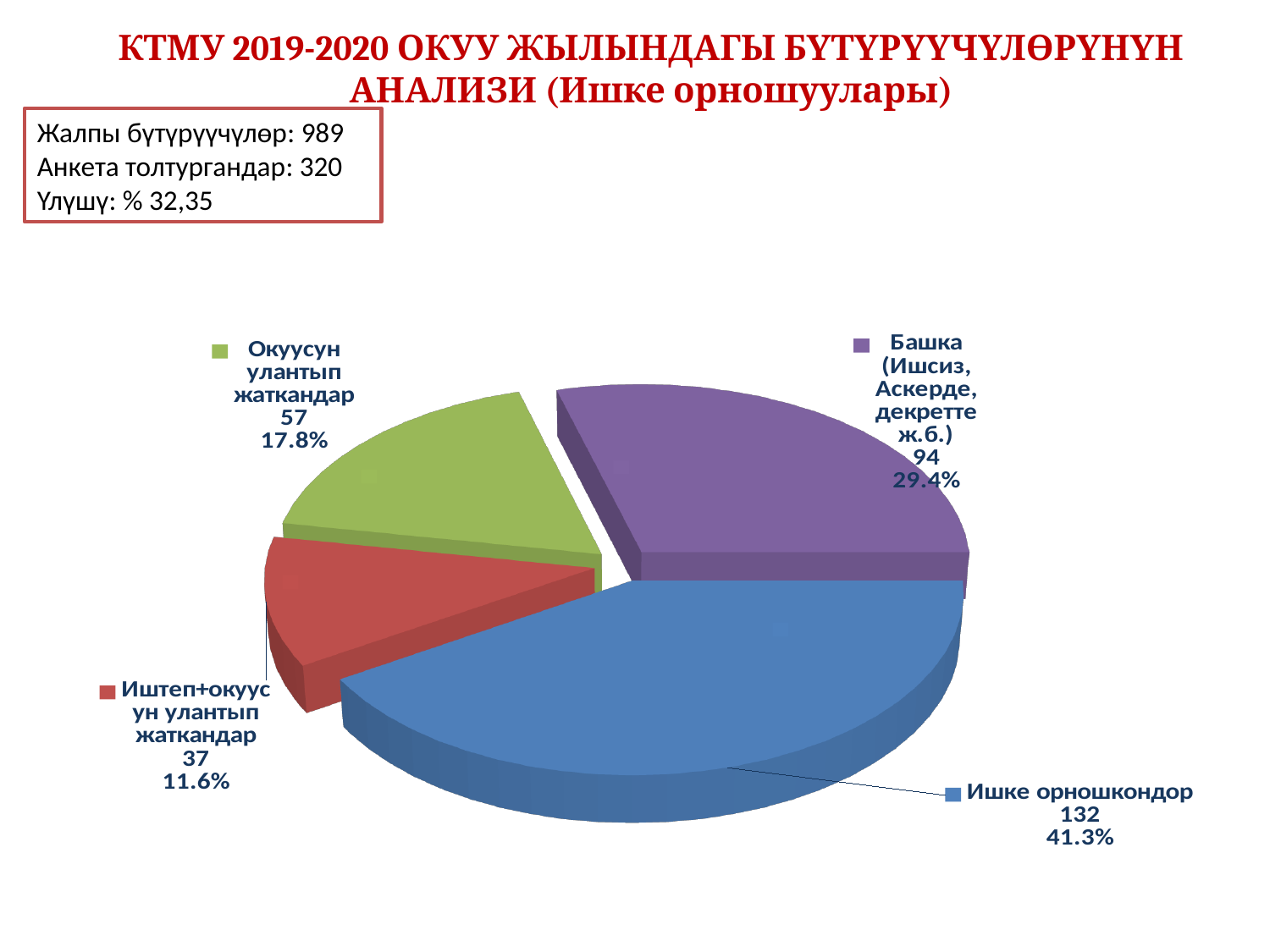
Which category has the largest slice of the pie? Ишке орношкондор What percentage share does the Ишке орношкондор slice have? 41.3% Which category has the smallest slice of the pie? Иштеп+окуусун улантып жаткандар How many slices does the pie chart have? 4 What percentage share does the Башка (Ишсиз, Аскерде, декретте ж.б.) slice have? 29.4% Which is larger, the value for Окуусун улантып жаткандар or the value for Иштеп+окуусун улантып жаткандар? Окуусун улантып жаткандар What is the difference between the values for Ишке орношкондор and Башка (Ишсиз, Аскерде, декретте ж.б.)? 38 What colour is the Ишке орношкондор slice? blue What is the value for Иштеп+окуусун улантып жаткандар? 37 What kind of chart is shown on the slide? pie chart What is the value for Ишке орношкондор? 132 What is the value for Окуусун улантып жаткандар? 57